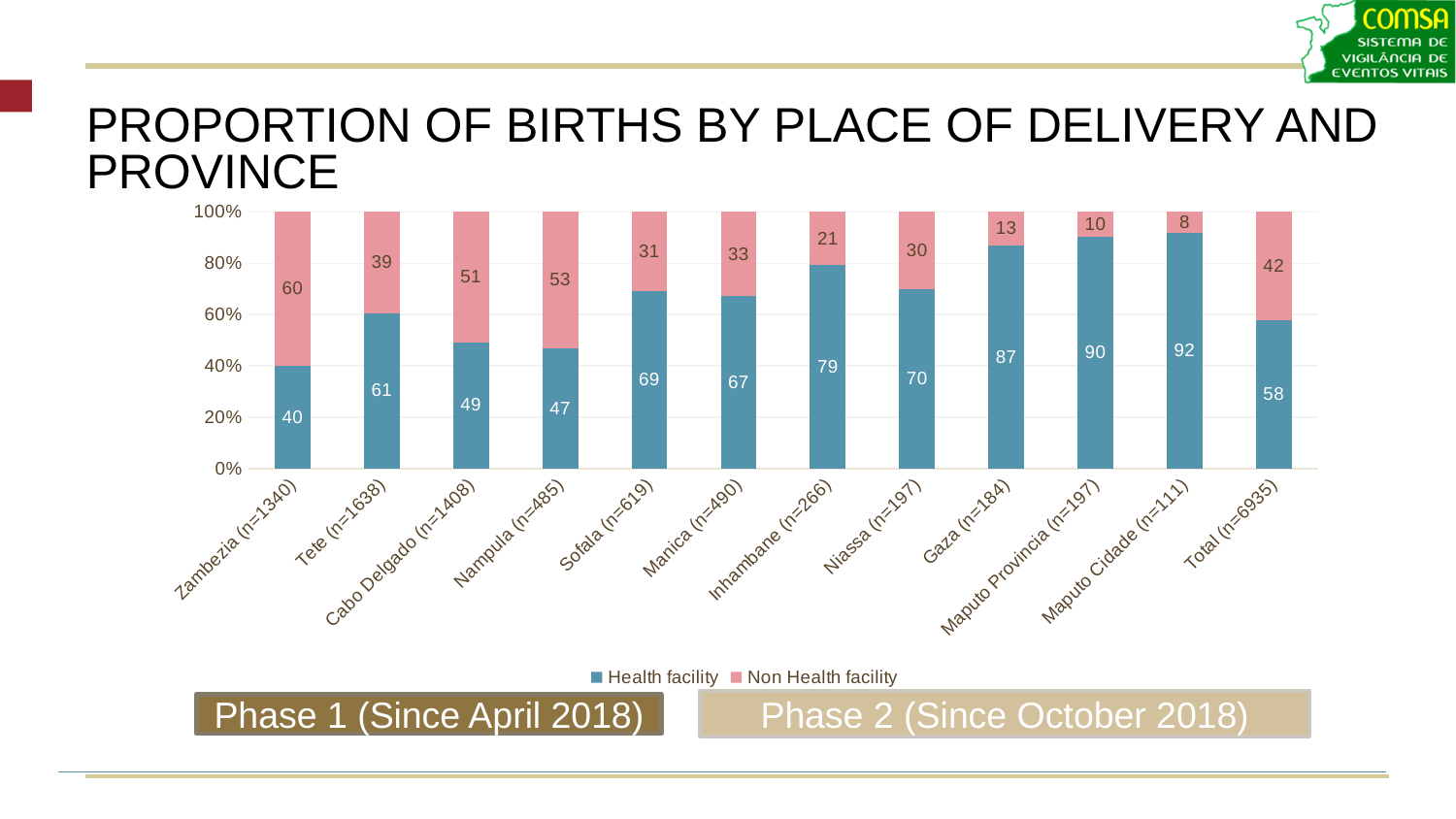
What kind of chart is shown on the slide? Stacked bar chart What is the total of the stacked bar for Sofala (n=619)? 100 How many series does the legend list? 2 What is the Health facility value for Zambezia (n=1340)? 40 Which has a larger Non Health facility value, Cabo Delgado (n=1408) or Nampula (n=485)? Nampula (n=485) What is the Health facility value for Total (n=6935)? 58 How many categories are shown on the x axis? 12 What is the difference between the Health facility values for Maputo Provincia (n=197) and Gaza (n=184)? 3 What is the Non Health facility value for Tete (n=1638)? 39 Which category has the highest Health facility value? Maputo Cidade (n=111) What is the title of the chart? PROPORTION OF BIRTHS BY PLACE OF DELIVERY AND PROVINCE Which category has the lowest Health facility value? Zambezia (n=1340)